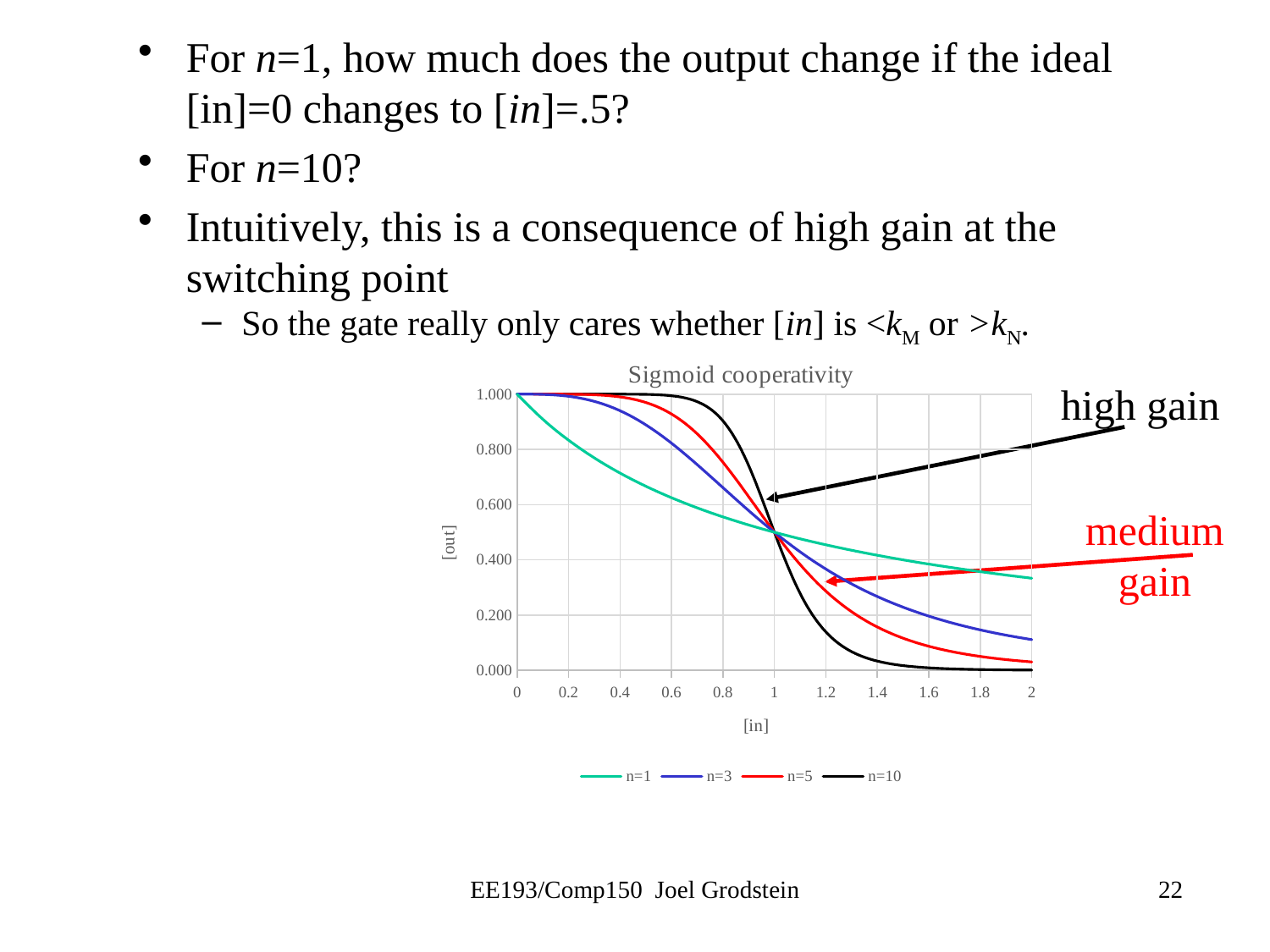
At [in]=1.6, which series has the larger value, n=1 or n=10? n=1 What is the title of the chart? Sigmoid cooperativity Is the value of the n=10 series at [in]=2 greater or less than 0.200? less What label is shown on the chart's vertical axis? [out] What kind of chart is shown on the slide? line chart Do the values of the n=10 series rise or fall as [in] increases? fall Is the value of the n=10 series at [in]=0.6 greater or less than 0.800? greater How many series does the chart legend list? 4 Is the value of the n=1 series at [in]=2 greater or less than 0.400? less At [in]=0.6, which series has the larger value, n=1 or n=10? n=10 What is the value of the n=1 series at [in]=0? 1.000